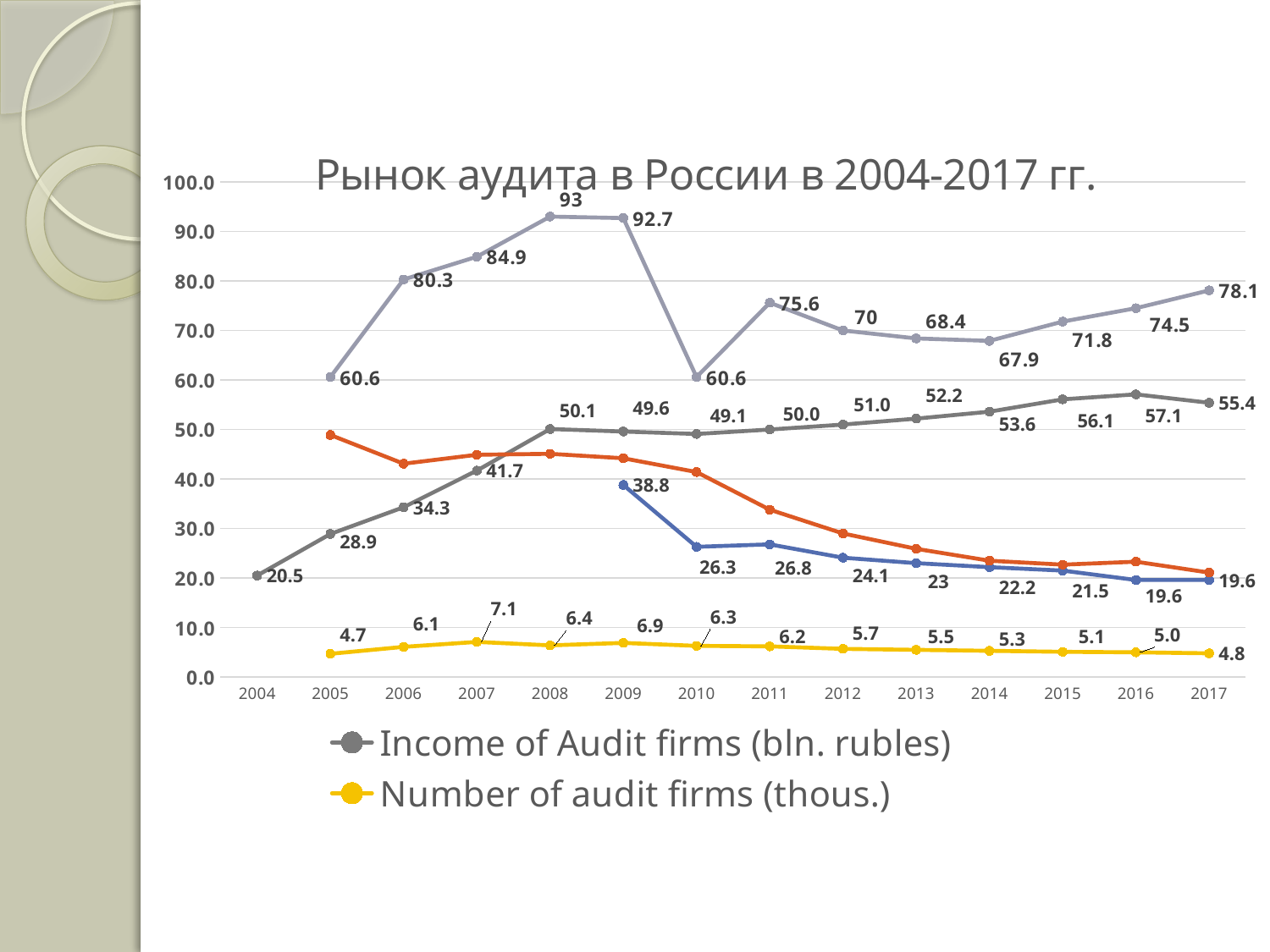
Which year has the higher Income of Audit firms (bln. rubles), 2015 or 2017? 2015 What is the Number of audit firms (thous.) in 2017? 4.8 What type of chart is shown on the slide? line chart What is the difference between the Number of audit firms (thous.) in 2007 and in 2017? 2.3 Does the Income of Audit firms (bln. rubles) rise or fall from 2004 to 2008? rise What is the Income of Audit firms (bln. rubles) in 2008? 50.1 What is the Number of audit firms (thous.) in 2007? 7.1 How many series does the legend list? 2 In which year is the Income of Audit firms (bln. rubles) highest? 2016 In which year is the Number of audit firms (thous.) highest? 2007 By how much did the Income of Audit firms (bln. rubles) increase from 2004 to 2017? 34.9 In which year is the Income of Audit firms (bln. rubles) lowest? 2004